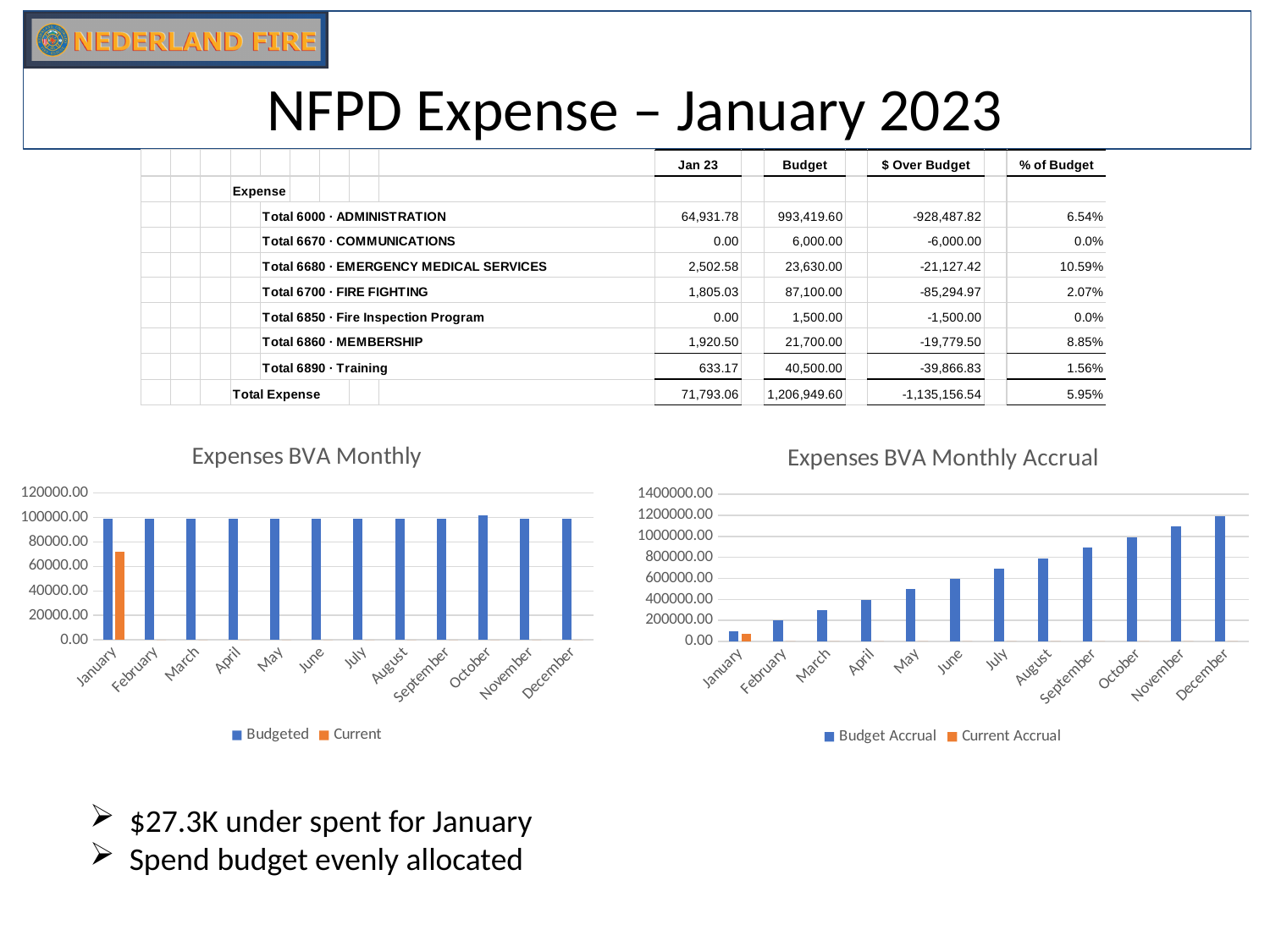
In the "Expenses BVA Monthly Accrual" chart, is the Current Accrual value for January greater or less than 200000.00? less How many series does the legend of the "Expenses BVA Monthly" chart list? 2 How many months are shown on the x axis of the "Expenses BVA Monthly Accrual" chart? 12 In the "Expenses BVA Monthly Accrual" chart, is the Budget Accrual value for December greater or less than 1000000.00? greater In the "Expenses BVA Monthly" chart, which is larger for January, Budgeted or Current? Budgeted In the "Expenses BVA Monthly" chart, is the Budgeted value for January greater or less than 80000.00? greater In the "Expenses BVA Monthly Accrual" chart, do the Budget Accrual values rise or fall from January to December? rise What are the two legend entries of the "Expenses BVA Monthly Accrual" chart? Budget Accrual and Current Accrual In the "Expenses BVA Monthly Accrual" chart, which month has the highest Budget Accrual value? December What kind of chart is the "Expenses BVA Monthly" chart? bar chart In the "Expenses BVA Monthly Accrual" chart, which month has the lowest Budget Accrual value? January